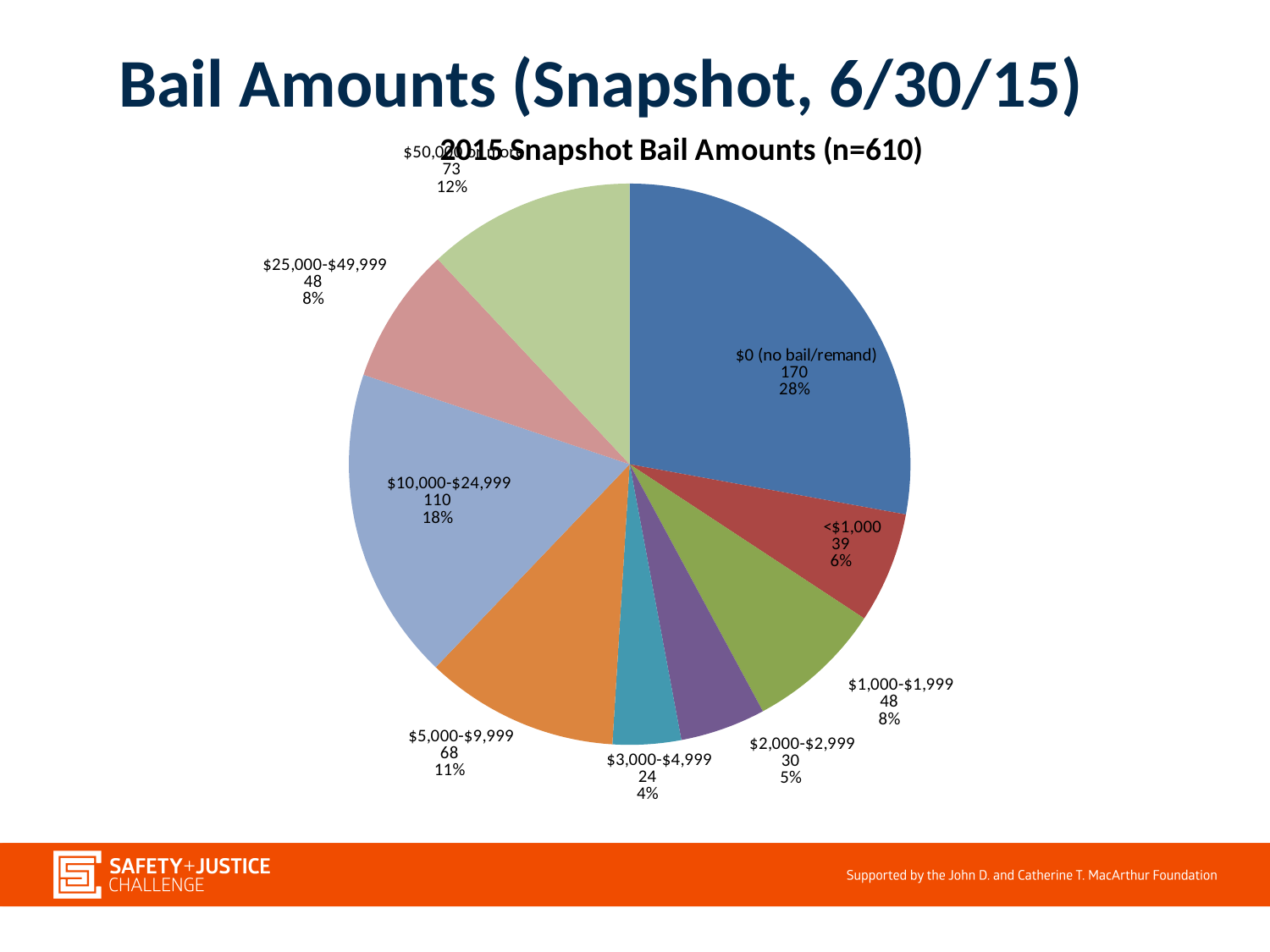
How many slices does the pie chart have? 9 What is the title of the chart? 2015 Snapshot Bail Amounts (n=610) What percentage of the pie does the $1,000-$1,999 slice represent? 8% Which category has the smallest slice of the pie? $3,000-$4,999 What is the difference in count between the $0 (no bail/remand) category and the $10,000-$24,999 category? 60 What percentage of the pie is the $10,000-$24,999 slice? 18% Which category has the largest slice of the pie? $0 (no bail/remand) How many cases fall in the $0 (no bail/remand) category? 170 What is the count for the $25,000-$49,999 category? 48 Which has a larger count, <$1,000 or $2,000-$2,999? <$1,000 What is the count for the $5,000-$9,999 category? 68 What type of chart is shown on the slide? pie chart